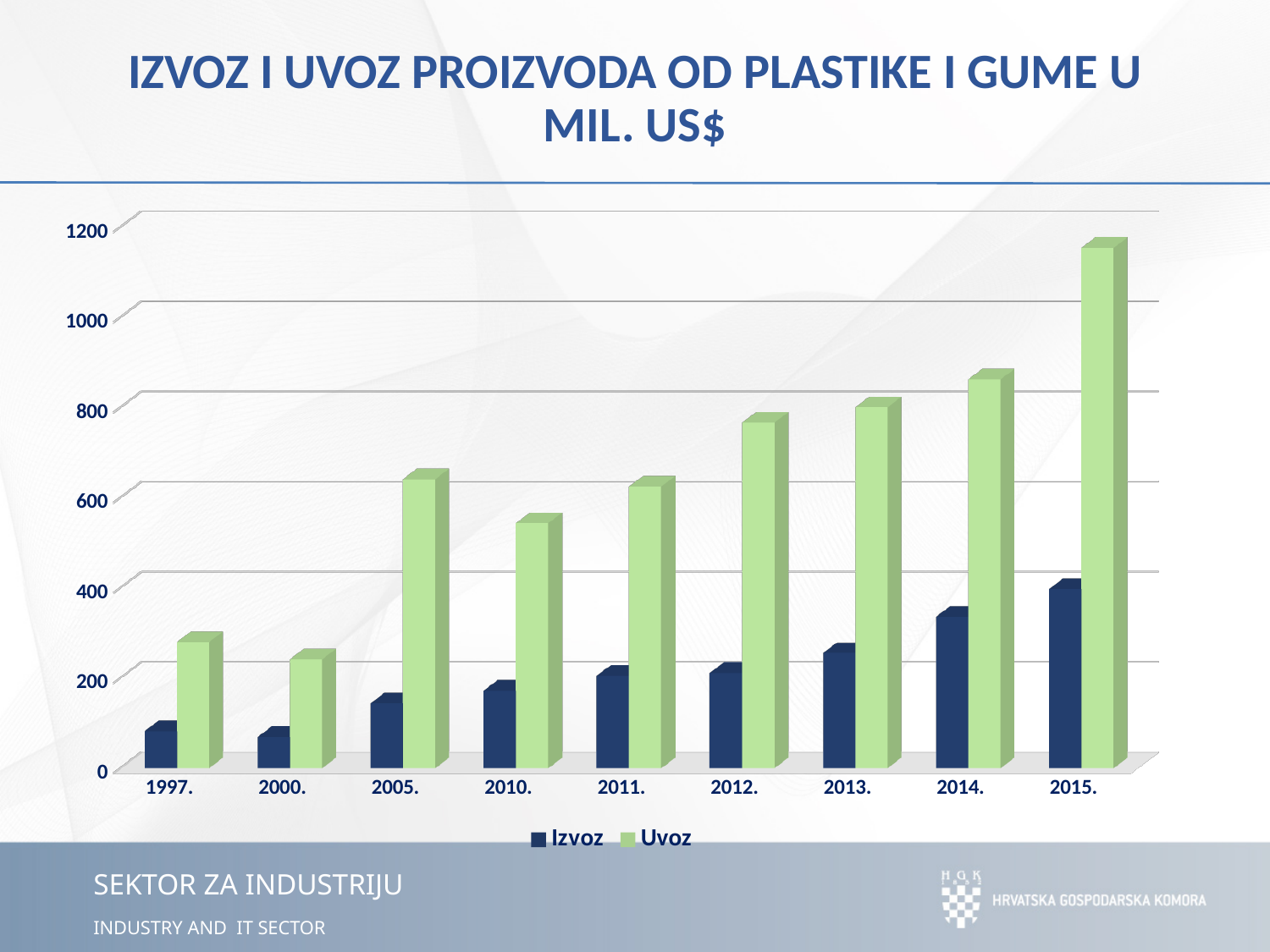
In which year is the Uvoz value highest? 2015. Do the Izvoz values rise or fall from 2010. to 2015.? rise Is the Uvoz value for 2010. greater or less than 600? less What kind of chart is shown on the slide? bar chart Is the Uvoz value for 2015. greater or less than 1000? greater In which year is the Izvoz value highest? 2015. How many series does the legend list? 2 Is the Izvoz value for 2014. greater or less than 200? greater Which is larger in 2015., Izvoz or Uvoz? Uvoz How many years are shown on the x axis? 9 In which year is the Uvoz value lowest? 2000.